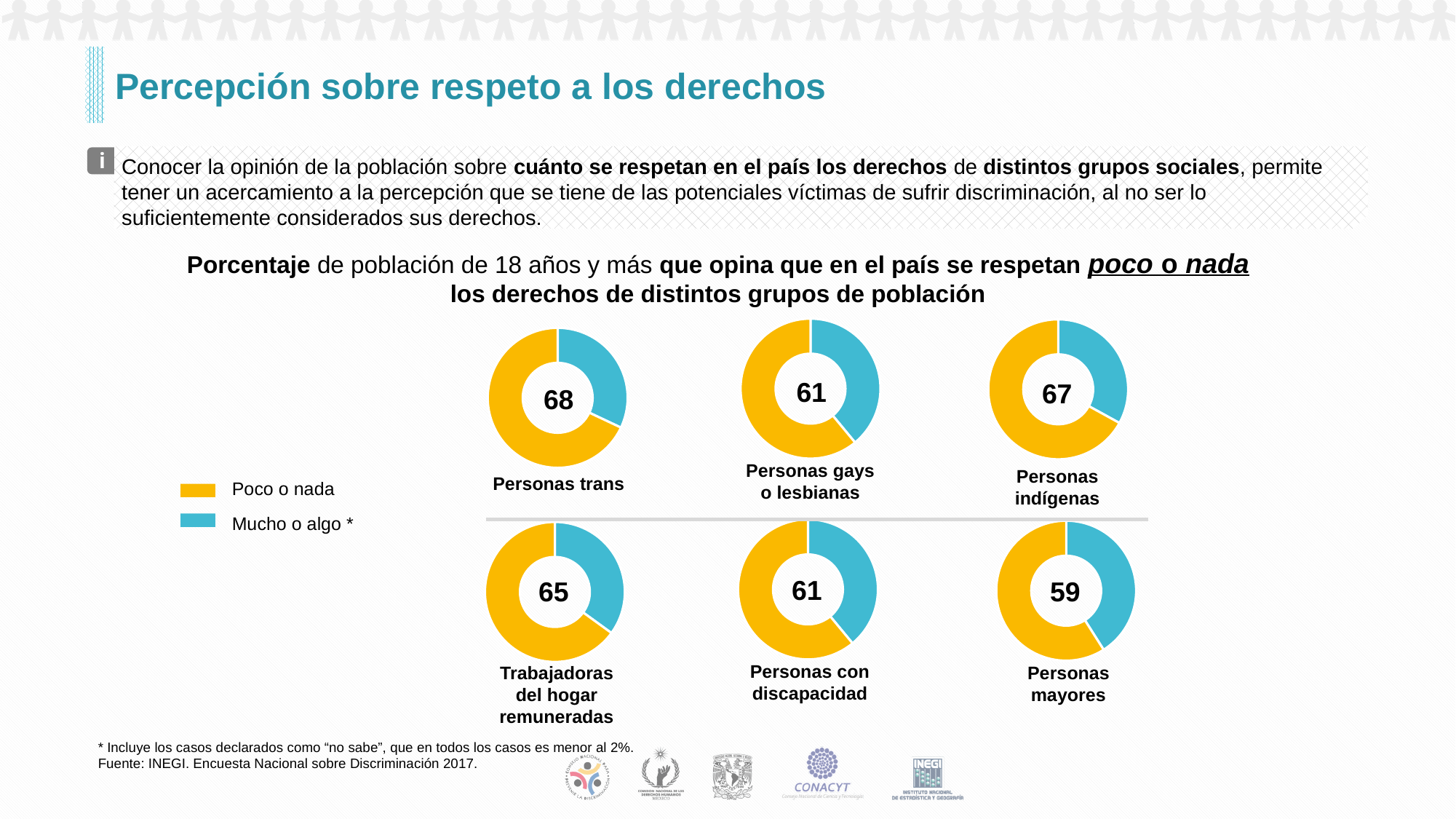
Which is larger, the value for Personas indígenas or the value for Trabajadoras del hogar remuneradas? Personas indígenas What kind of chart is used to show the values for each group? Donut (pie) chart What value is shown in the donut chart for Trabajadoras del hogar remuneradas? 65 What value is shown in the donut chart for Personas mayores? 59 What is the difference between the values for Personas trans and Personas mayores? 9 Which colour represents 'Poco o nada' in the charts? Yellow/orange Which group has the highest percentage of people saying its rights are respected poco o nada? Personas trans How many donut charts (population groups) are shown on the slide? 6 How many categories does the legend list? 2 What percentage of the population aged 18 and over thinks the rights of Personas trans are respected poco o nada? 68 Which group has the lowest percentage of people saying its rights are respected poco o nada? Personas mayores What value is shown in the donut chart for Personas indígenas? 67